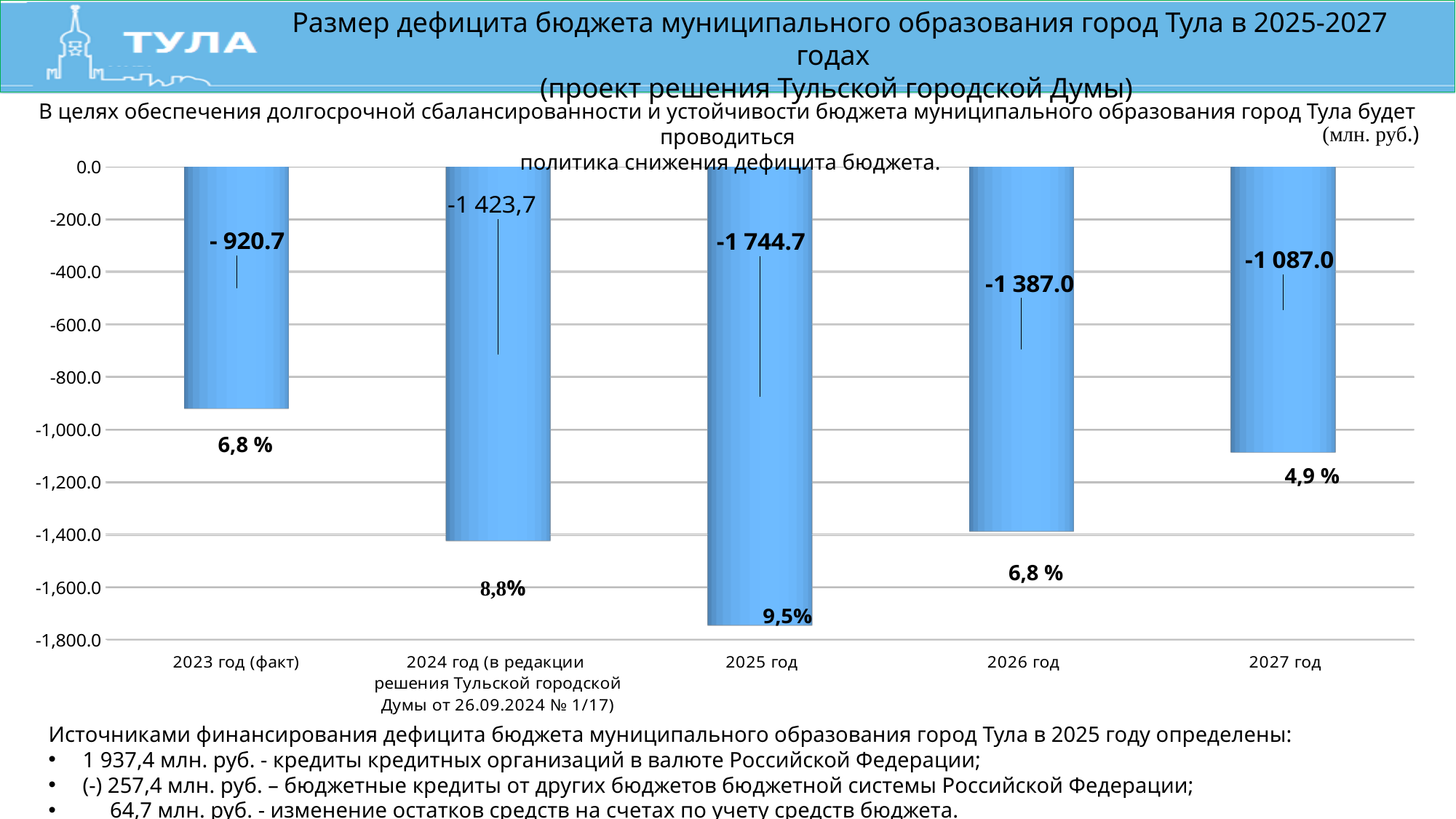
What percentage is shown under the bar for 2026 год? 6,8 % Does the size of the deficit rise or fall from 2025 год to 2027 год? Falls In what units are the chart values given, according to the label at the top right of the chart? млн. руб. What is the budget deficit value shown for 2025 год? -1 744.7 How many years (bars) are shown in the chart? 5 What type of chart is shown on the slide? Bar chart Which has the larger deficit in absolute value: 2024 год or 2027 год? 2024 год Which year has the smallest budget deficit (the shortest bar)? 2023 год (факт) By how much does the deficit for 2025 год exceed the deficit for 2026 год in absolute value? 357.7 What is the budget deficit value shown for 2027 год? -1 087.0 What is the budget deficit value shown for 2023 год (факт)? - 920.7 Which year has the largest budget deficit (the longest bar)? 2025 год